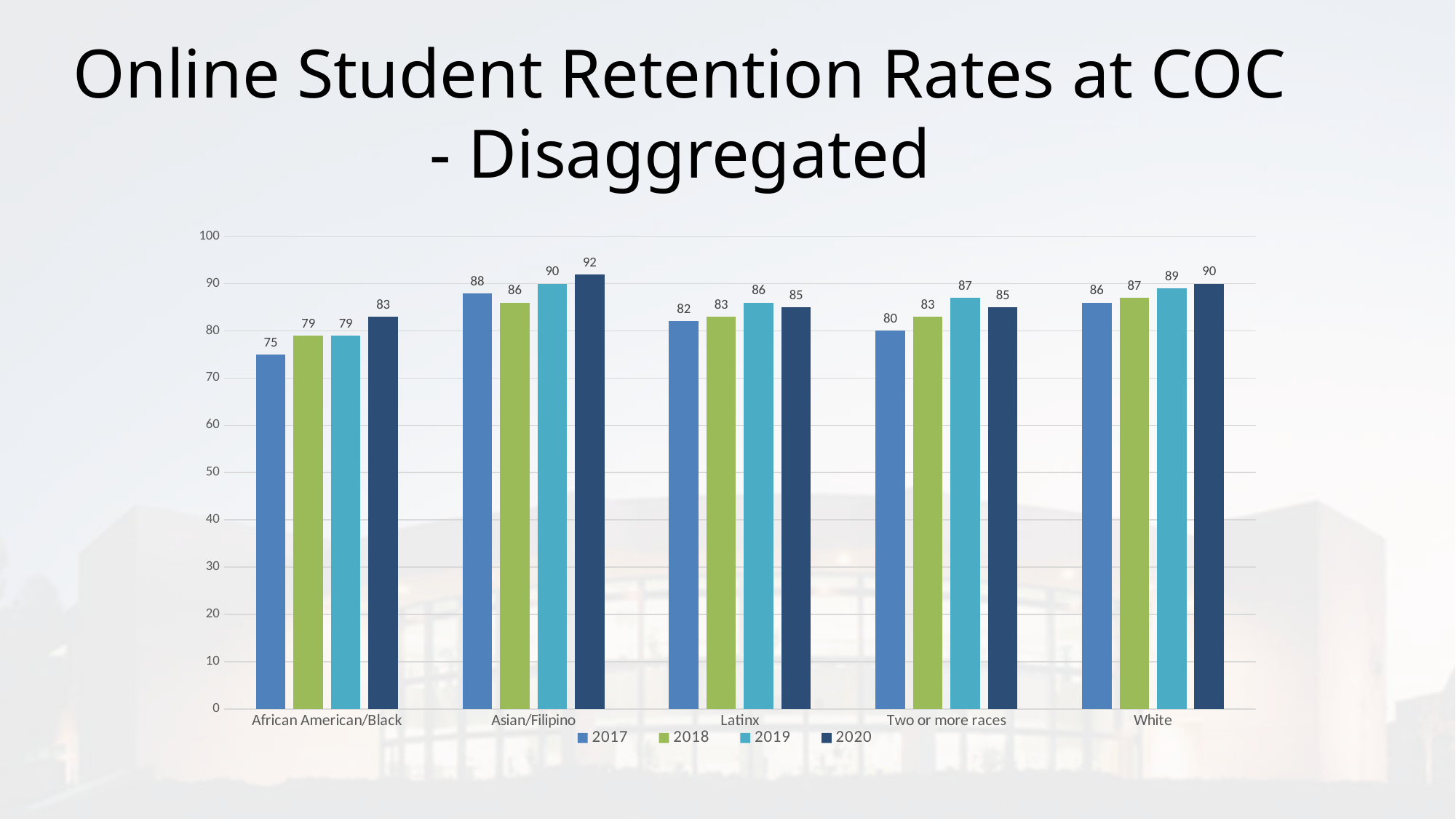
Which category has the lowest 2017 retention rate? African American/Black Do the retention rates for Asian/Filipino students rise or fall from 2018 to 2020? Rise What is the 2017 retention rate for Asian/Filipino students? 88 What is the 2020 retention rate for African American/Black students? 83 How many categories are shown on the x axis? 5 What is the difference between the 2020 and 2017 retention rates for African American/Black students? 8 What is the 2019 retention rate for Latinx students? 86 How many series does the legend list? 4 Which is larger: the 2019 retention rate for Two or more races or the 2019 retention rate for White students? White Which category has the highest 2020 retention rate? Asian/Filipino What is the title of the slide? Online Student Retention Rates at COC - Disaggregated What kind of chart is shown on the slide? Bar chart